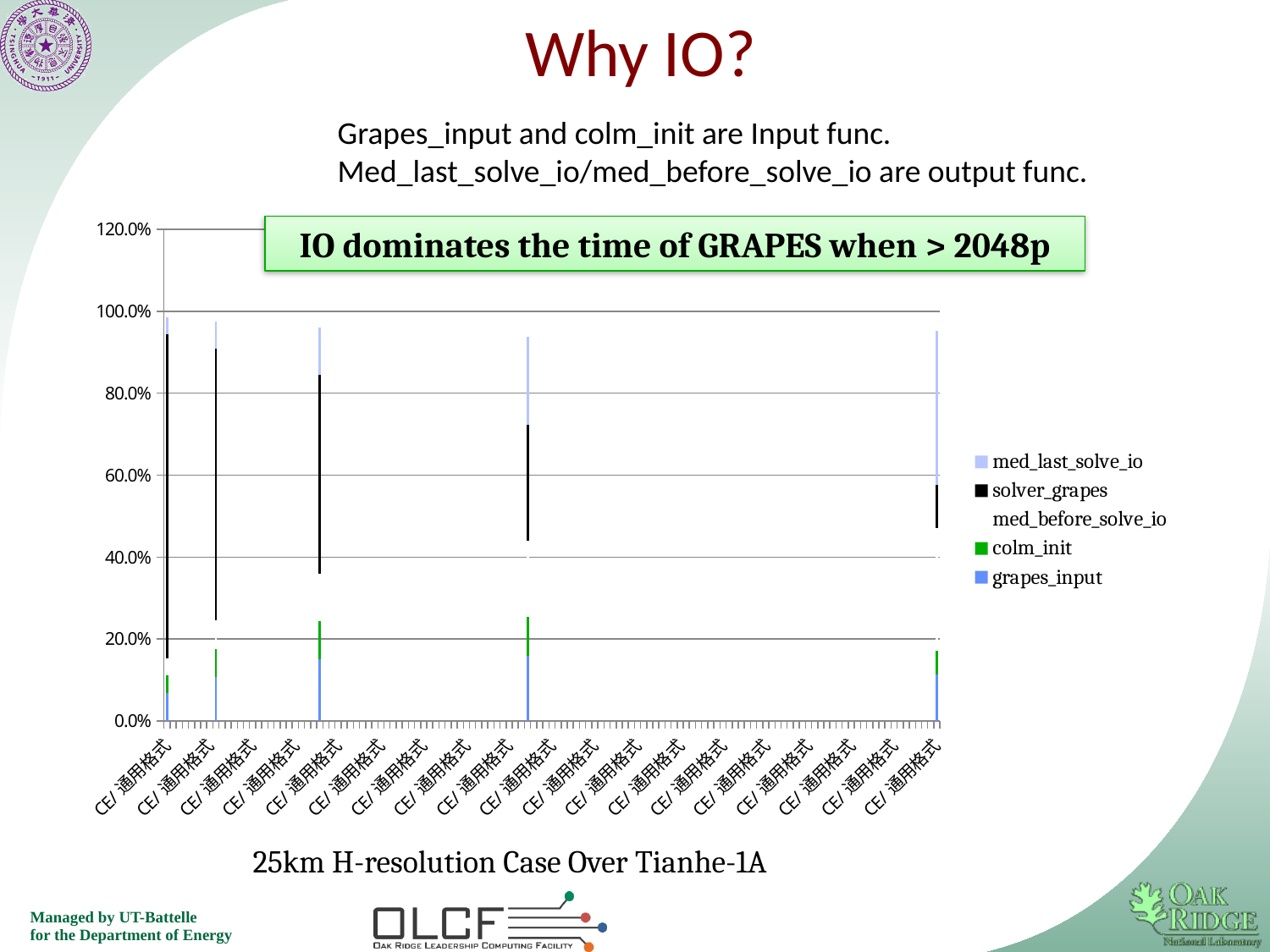
Which series is listed first in the chart legend? med_last_solve_io Is the total height of the leftmost bar greater or less than 80%? greater What kind of chart is shown on the slide? bar chart Moving from the leftmost bar to the rightmost bar, does the solver_grapes (black) segment rise or fall? fall What is the highest value shown on the chart's vertical axis? 120.0% Is the total height of the rightmost bar greater or less than 80%? greater How many series does the chart legend list? 5